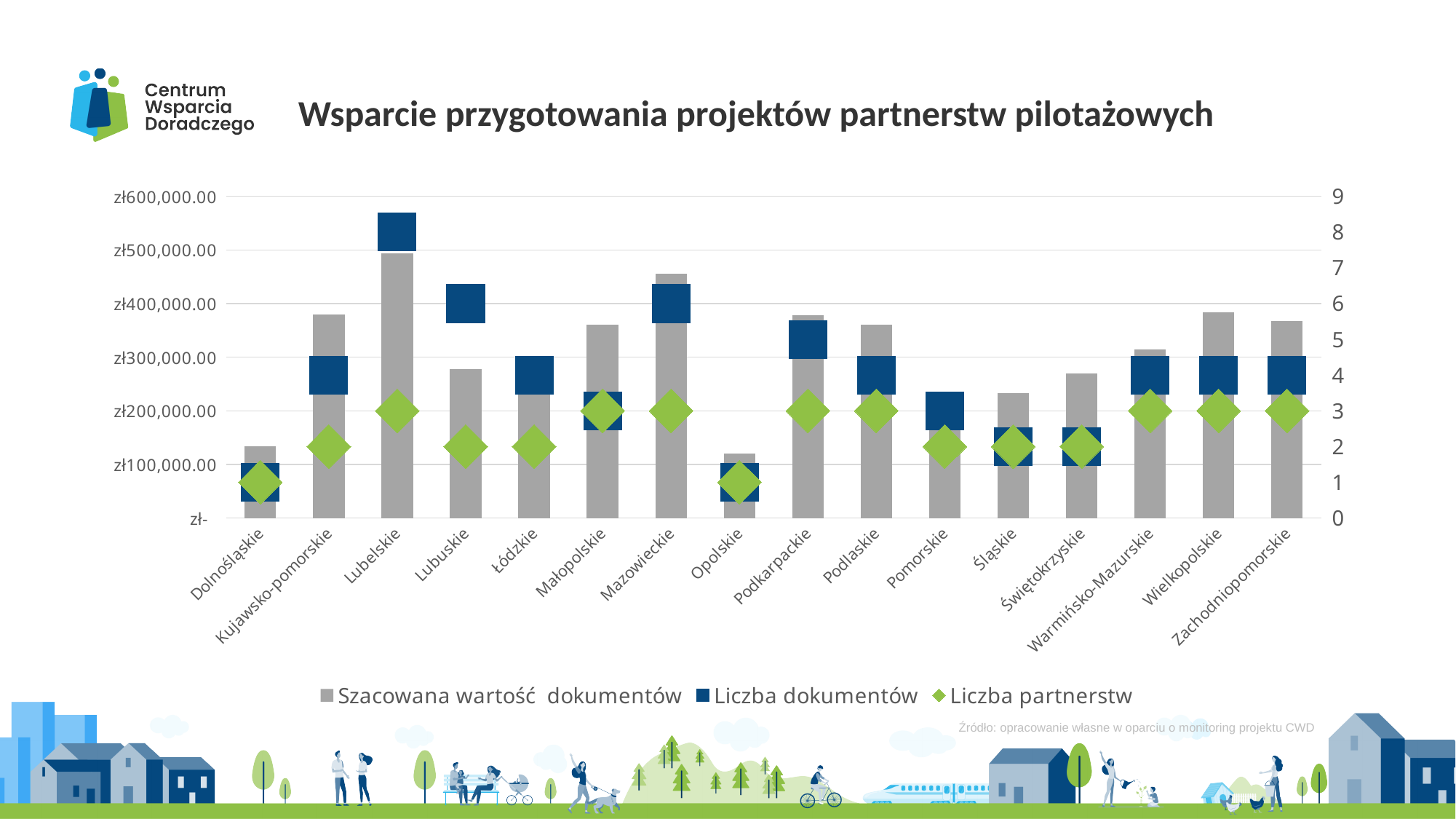
What is the Liczba partnerstw value for Opolskie? 1 What is the Liczba partnerstw value for Kujawsko-pomorskie? 2 What is the difference between Liczba dokumentów and Liczba partnerstw for Lubuskie? 4 Is the Szacowana wartość dokumentów for Lubuskie greater or less than zł300,000.00? less What type of chart is shown on the slide? Combination bar and line/marker chart How many series does the legend list? 3 Is the Szacowana wartość dokumentów for Mazowieckie greater or less than zł400,000.00? greater What is the Liczba dokumentów value for Mazowieckie? 6 How many voivodeships (categories) are shown on the x axis? 16 Which voivodeship has the highest Szacowana wartość dokumentów bar? Lubelskie Which is larger: the Liczba dokumentów for Podkarpackie or for Pomorskie? Podkarpackie What is the Liczba dokumentów value for Lubelskie? 8